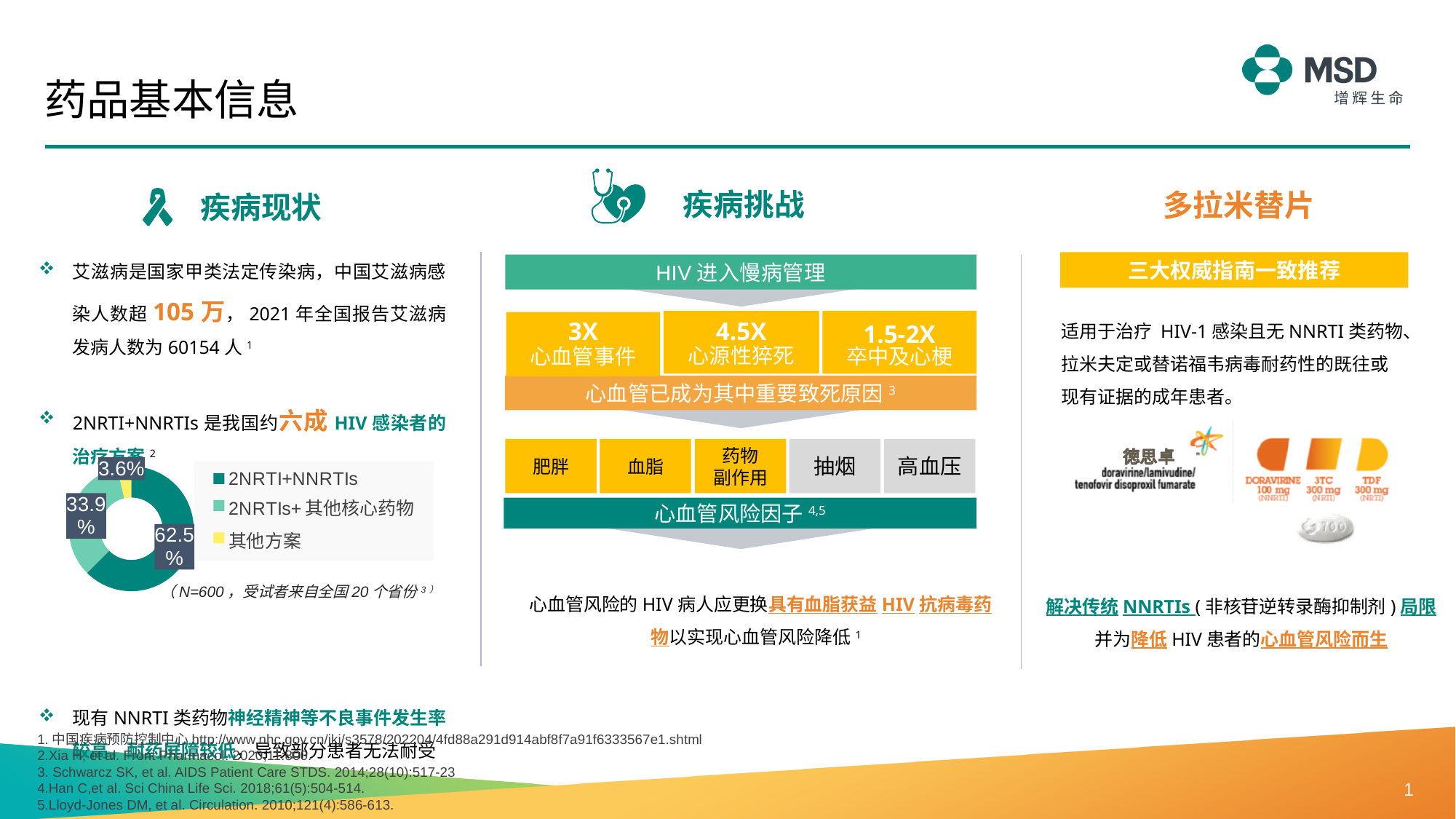
How many categories does the legend of the donut chart list? 3 Which is larger in the donut chart: 2NRTIs+其他核心药物 or 其他方案? 2NRTIs+其他核心药物 What colour is the 其他方案 slice in the donut chart? Yellow Which category has the smallest slice in the donut chart? 其他方案 According to the note under the donut chart, what is the sample size N? 600 What is the difference in percentage points between the 2NRTI+NNRTIs slice and the 2NRTIs+其他核心药物 slice? 28.6 What kind of chart is shown in the 疾病现状 section of the slide? Donut (pie) chart Which category has the largest slice in the donut chart? 2NRTI+NNRTIs In the donut chart, what share is labelled for 2NRTIs+其他核心药物? 33.9% In the donut chart, what share is labelled for 其他方案? 3.6% In the donut chart, what share is labelled for 2NRTI+NNRTIs? 62.5% What colour is the 2NRTI+NNRTIs slice in the donut chart? Dark teal green